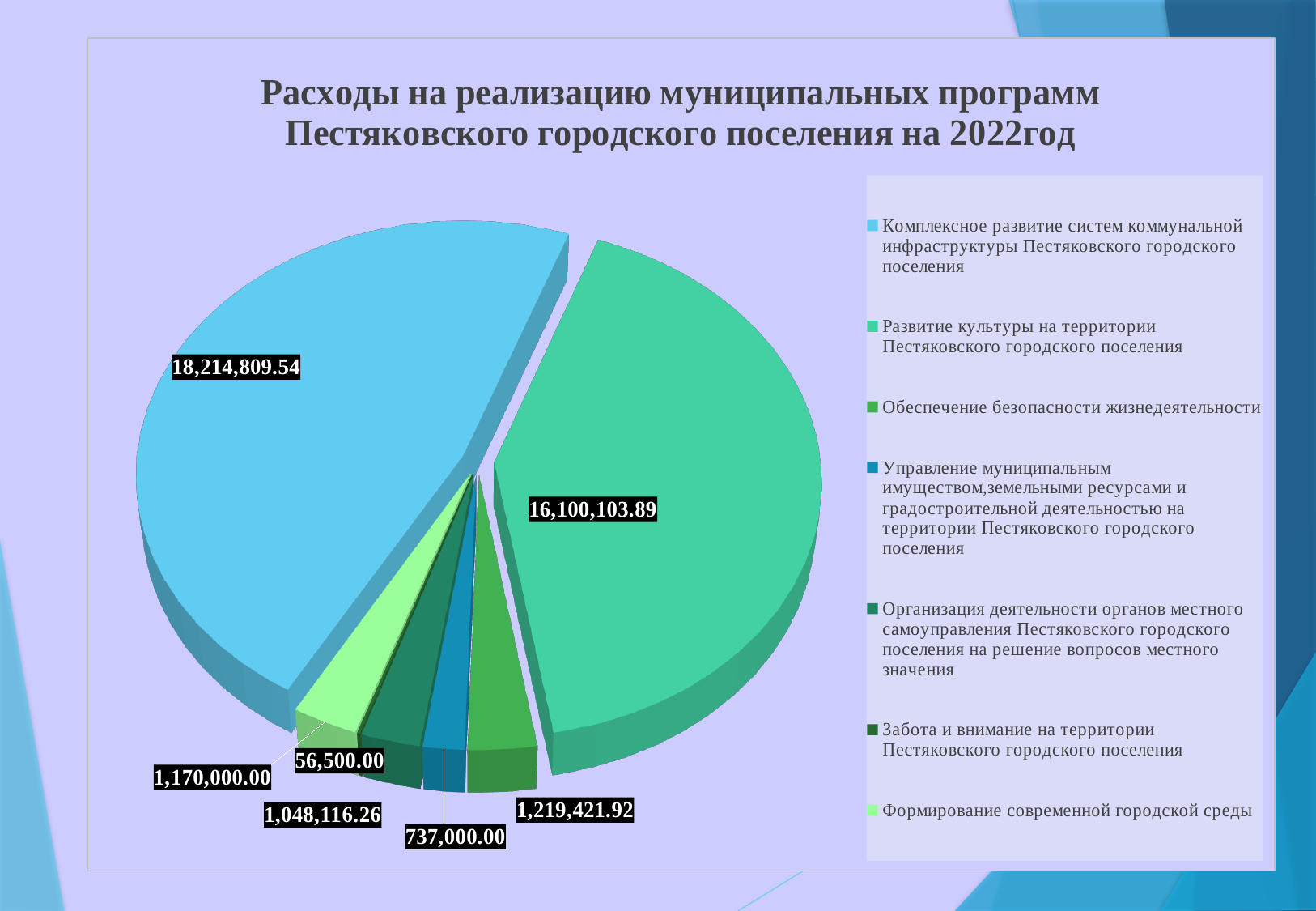
What is the difference between the values for «Комплексное развитие систем коммунальной инфраструктуры» and «Развитие культуры»? 2,114,705.65 Which program has the largest expenditure? Комплексное развитие систем коммунальной инфраструктуры Пестяковского городского поселения Which is larger: the value for «Обеспечение безопасности жизнедеятельности» or for «Организация деятельности органов местного самоуправления»? Обеспечение безопасности жизнедеятельности What is the title of the chart? Расходы на реализацию муниципальных программ Пестяковского городского поселения на 2022год How many slices does the pie chart have? 7 What is the value for «Развитие культуры на территории Пестяковского городского поселения»? 16,100,103.89 Which program has the smallest expenditure? Забота и внимание на территории Пестяковского городского поселения What is the value for «Комплексное развитие систем коммунальной инфраструктуры Пестяковского городского поселения»? 18,214,809.54 What kind of chart is shown on the slide? Pie chart How many entries does the legend list? 7 What is the value for «Формирование современной городской среды»? 1,170,000.00 What is the value for «Управление муниципальным имуществом, земельными ресурсами и градостроительной деятельностью»? 737,000.00